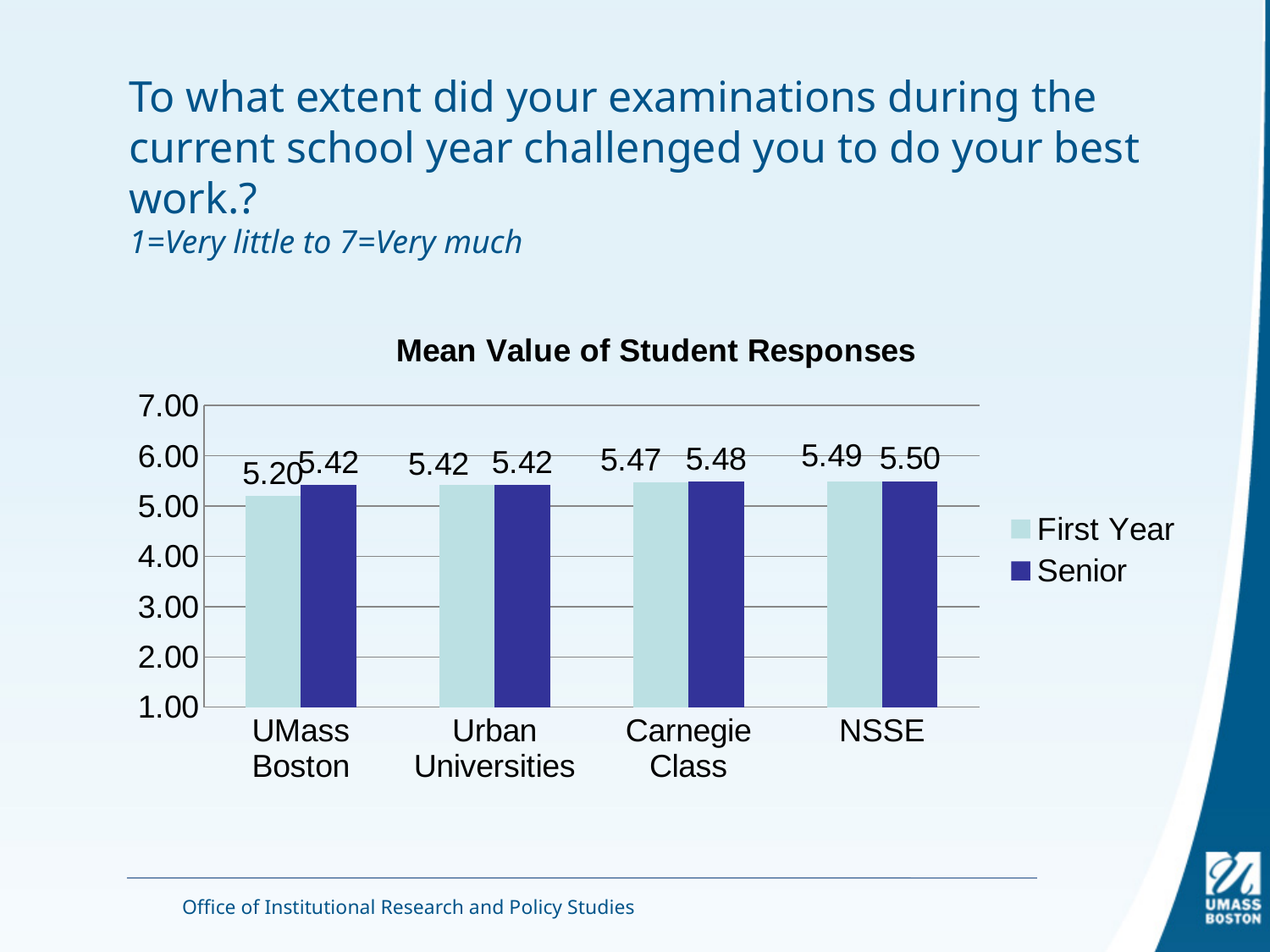
How many categories are shown on the x axis? 4 What is the Senior value for NSSE? 5.50 What is the First Year value for Carnegie Class? 5.47 Which category has the highest Senior value? NSSE Which category has the lowest First Year value? UMass Boston Is the Senior value for Urban Universities greater or less than 5.00? greater Which is larger, the First Year value for UMass Boston or the First Year value for NSSE? NSSE What is the difference between the Senior and First Year values for UMass Boston? 0.22 What is the title of the chart? Mean Value of Student Responses How many series does the legend list? 2 What kind of chart is shown on the slide? Bar chart What is the First Year value for UMass Boston? 5.20